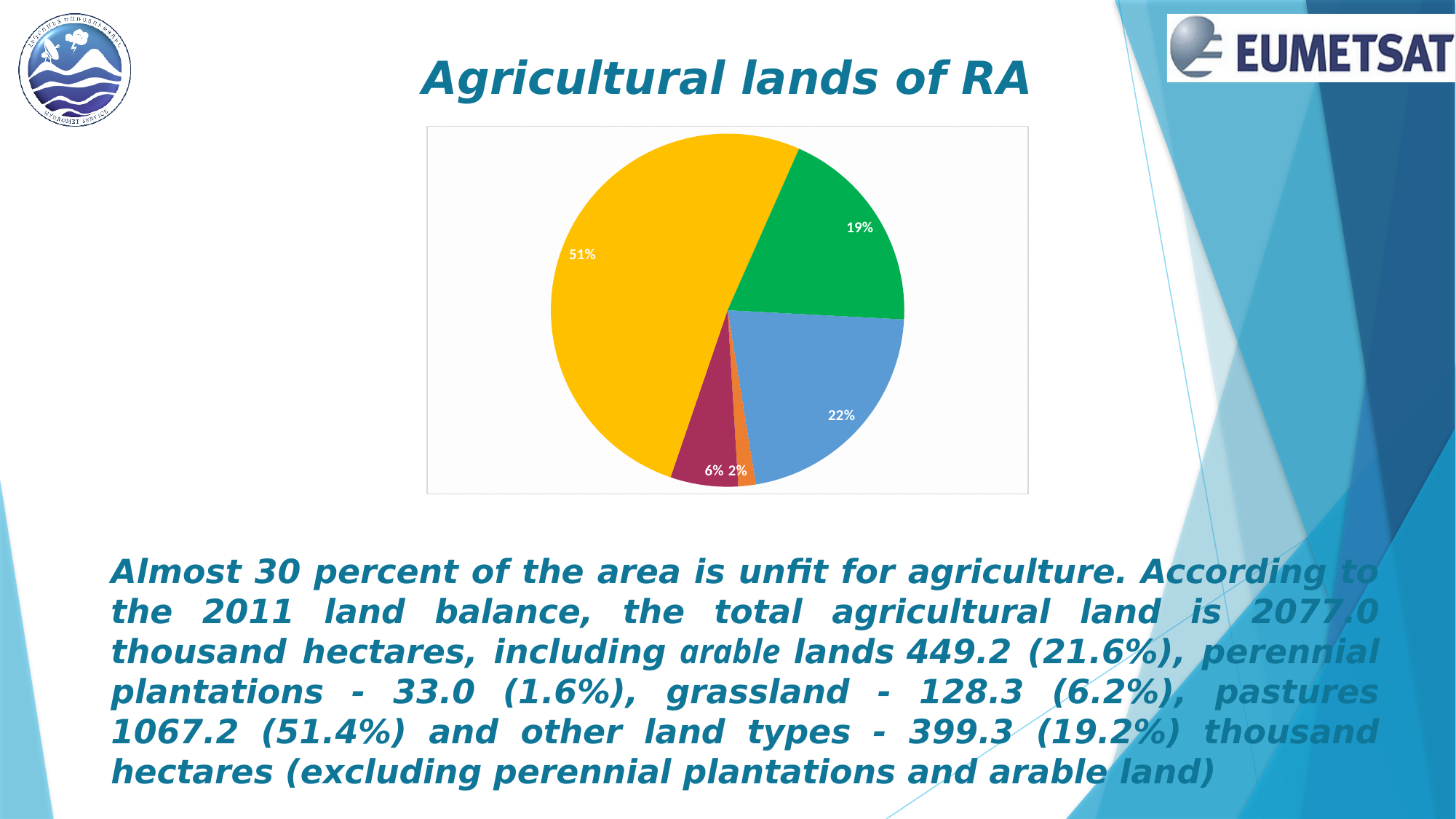
What is the difference in percentage points between the magenta slice and the orange slice? 4 How many slices does the pie chart have? 5 What percentage is shown on the smallest slice of the pie chart? 2% What is the title of the slide containing the pie chart? Agricultural lands of RA What value is labelled on the yellow slice of the pie chart? 51% Which slice is larger, the blue slice or the green slice? blue slice What value is labelled on the magenta slice of the pie chart? 6% What kind of chart is shown on the slide? pie chart What value is labelled on the green slice of the pie chart? 19% What is the difference in percentage points between the yellow slice and the blue slice? 29 What value is labelled on the blue slice of the pie chart? 22% What percentage is shown on the largest slice of the pie chart? 51%